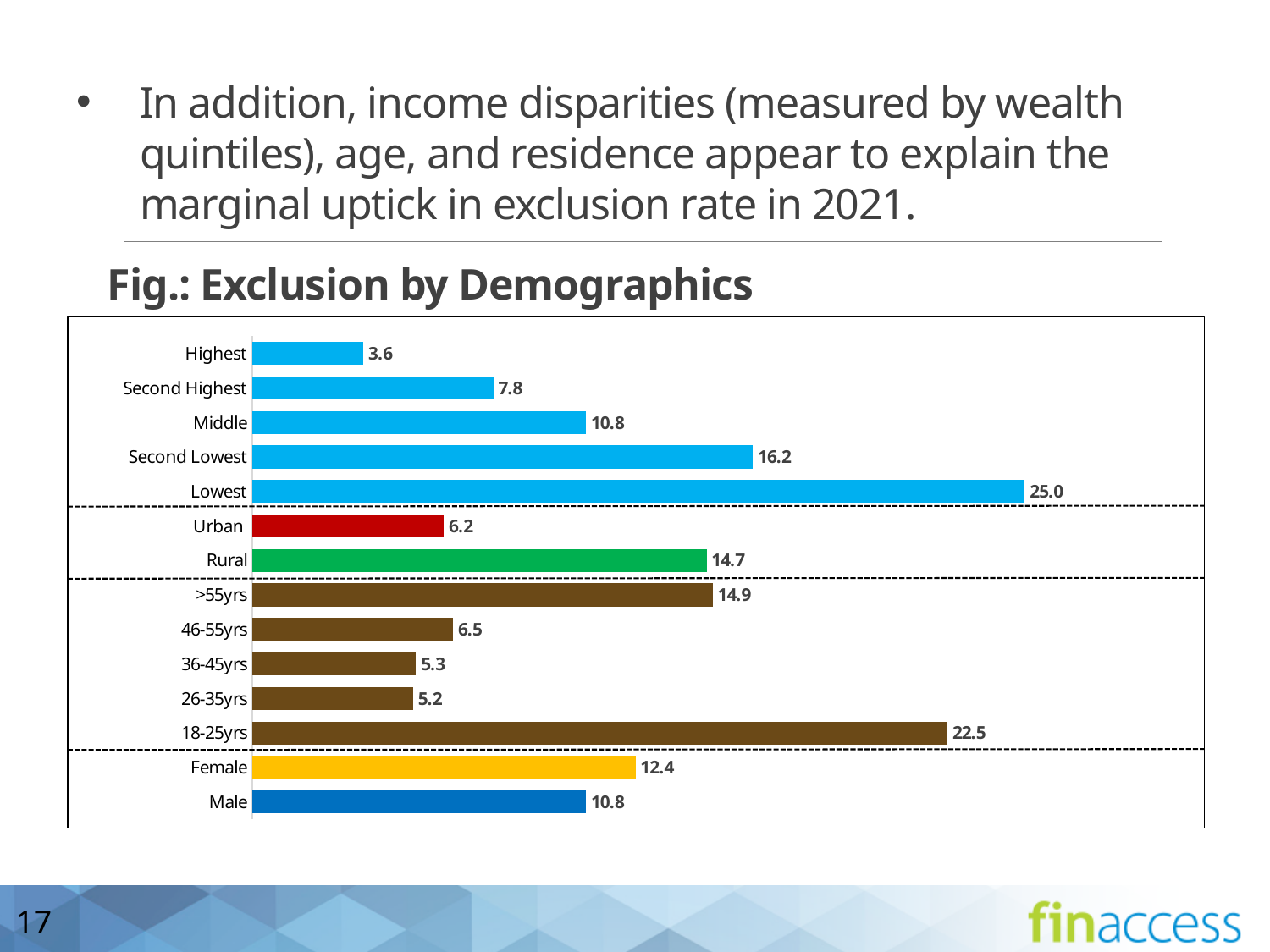
Which is larger, the value for >55yrs or the value for 46-55yrs? >55yrs What is the difference between the Rural and Urban values? 8.5 Which category has the highest value in the chart? Lowest Which category has the lowest value in the chart? Highest How many bars are shown in the chart? 14 What is the exclusion value for the Lowest wealth quintile? 25.0 What is the value shown for the 18-25yrs age group? 22.5 What type of chart is shown on the slide? Bar chart What is the value shown for Urban? 6.2 What is the title of the figure on the slide? Fig.: Exclusion by Demographics What is the difference between the Female and Male values? 1.6 What is the value shown for Female? 12.4